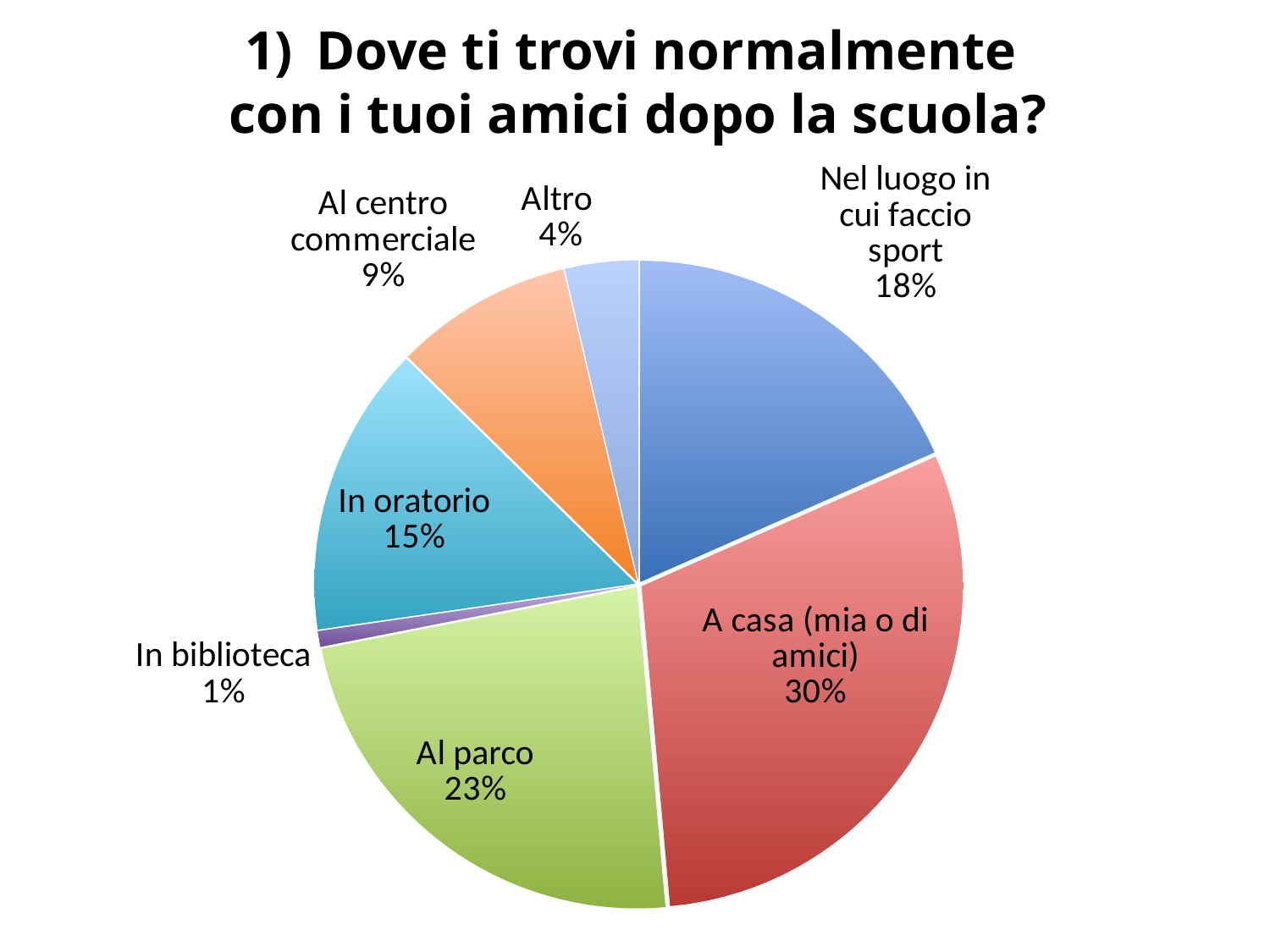
Which is larger, the value for "In oratorio" or the value for "Nel luogo in cui faccio sport"? Nel luogo in cui faccio sport What is the value shown for "In oratorio"? 15% Which category has the largest slice of the pie? A casa (mia o di amici) What share of the pie does "A casa (mia o di amici)" represent? 30% What is the value shown for "Nel luogo in cui faccio sport"? 18% What kind of chart is shown on the slide? Pie chart What is the value shown for "Al centro commerciale"? 9% What is the difference between the values for "A casa (mia o di amici)" and "Al parco"? 7% What is the value shown for "Al parco"? 23% How many categories are shown in the pie chart? 7 What is the title of the chart? 1) Dove ti trovi normalmente con i tuoi amici dopo la scuola? Which category has the smallest slice of the pie? In biblioteca